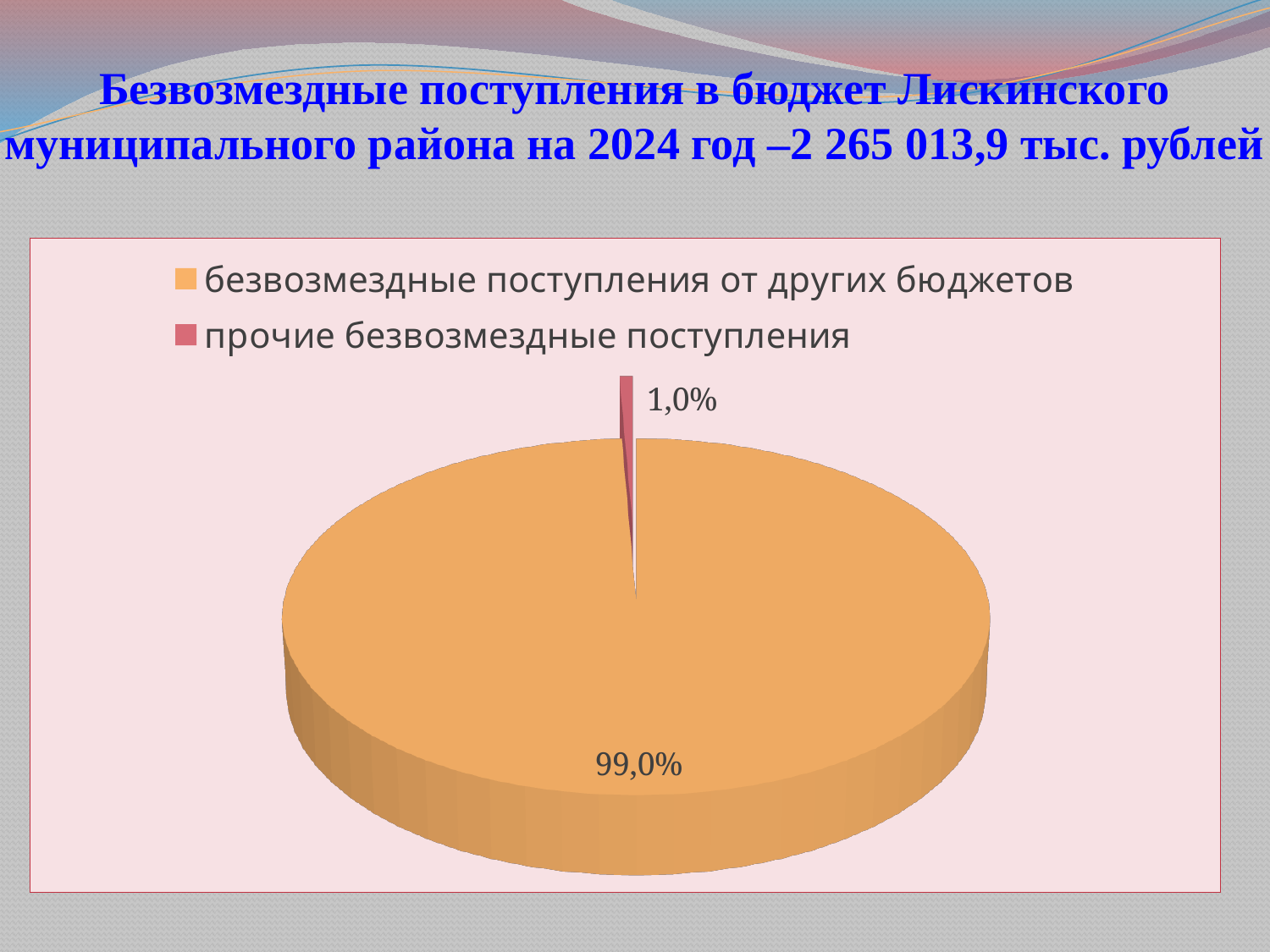
Which category has the largest slice of the pie? безвозмездные поступления от других бюджетов Which is larger: the share for "прочие безвозмездные поступления" or the share for "безвозмездные поступления от других бюджетов"? безвозмездные поступления от других бюджетов What share of the pie does "безвозмездные поступления от других бюджетов" take? 99,0% What kind of chart is shown on the slide? Pie chart What colour is the slice for "прочие безвозмездные поступления"? Red (pink) Which category has the smallest slice of the pie? прочие безвозмездные поступления What total amount of gratuitous receipts for 2024 is stated in the slide title? 2 265 013,9 тыс. рублей How many slices does the pie chart have? 2 What share of the pie does "прочие безвозмездные поступления" take? 1,0% How many entries does the legend list? 2 What is the difference in percentage points between the two slices of the pie? 98,0%